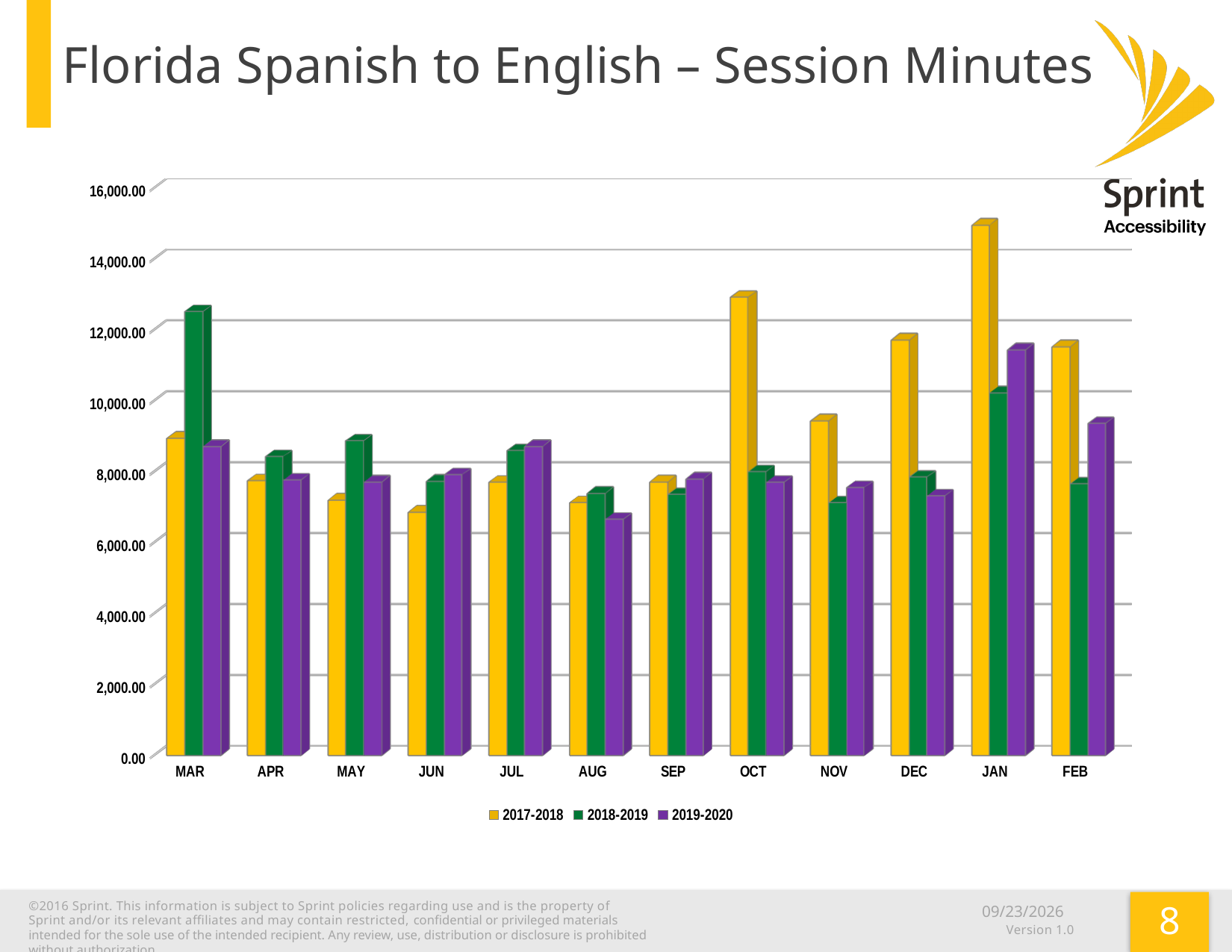
How many months are shown along the x axis? 12 Is the 2019-2020 value for JAN greater or less than 10,000.00? greater Is the 2017-2018 value for JAN greater or less than 14,000.00? greater In which month is the 2017-2018 value highest? JAN In which month is the 2017-2018 value lowest? JUN Is the 2018-2019 value for MAR greater or less than 12,000.00? greater What are the three series named in the legend? 2017-2018, 2018-2019, 2019-2020 In which month is the 2018-2019 value highest? MAR How many series does the legend list? 3 In which month is the 2019-2020 value lowest? AUG What kind of chart is shown on the slide? bar chart For OCT, which series has the larger value, 2017-2018 or 2018-2019? 2017-2018